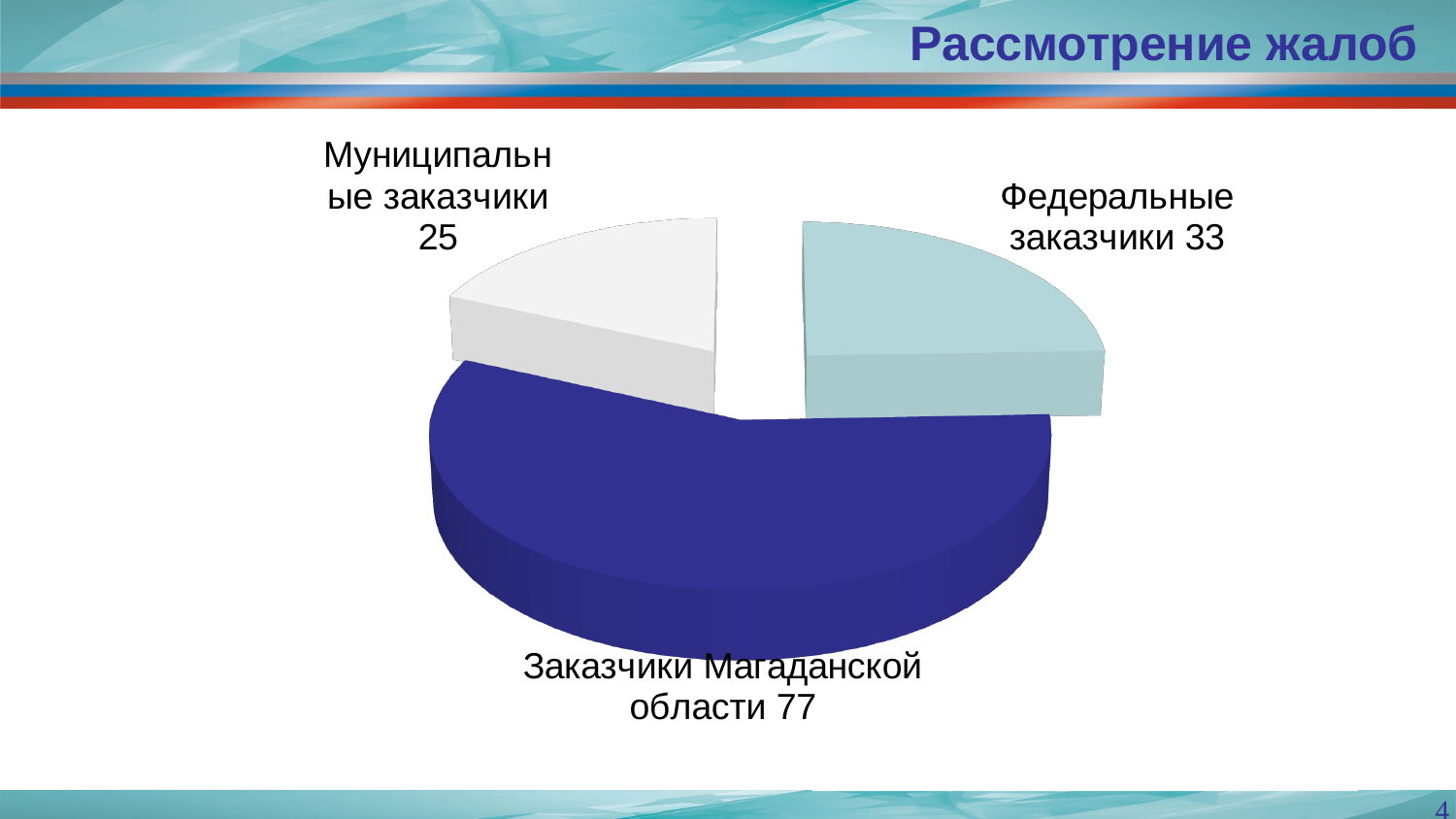
What is the difference between the values for Заказчики Магаданской области and Федеральные заказчики? 44 What value is shown for Заказчики Магаданской области? 77 What kind of chart is shown on the slide? Pie chart Which category has the smallest slice of the pie? Муниципальные заказчики Which is larger: the value for Федеральные заказчики or the value for Муниципальные заказчики? Федеральные заказчики What is the difference between the values for Федеральные заказчики and Муниципальные заказчики? 8 What is the title of the slide containing the chart? Рассмотрение жалоб Which category has the largest slice of the pie? Заказчики Магаданской области What value is shown for Муниципальные заказчики? 25 What value is shown for Федеральные заказчики? 33 How many categories are shown in the pie chart? 3 What is the total of all three values in the pie chart? 135